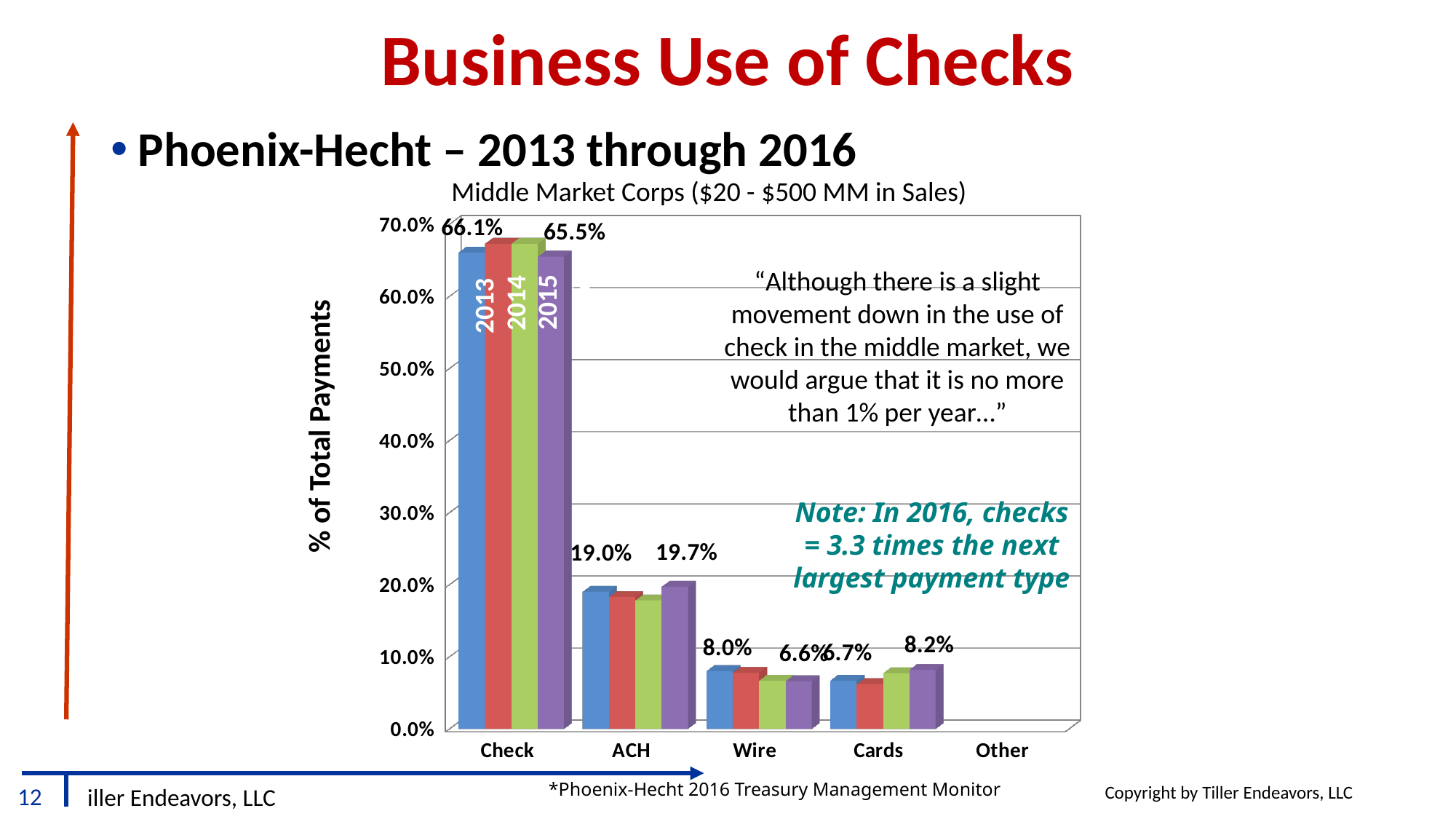
How many payment-type categories are shown on the x axis? 5 What is the difference between the rightmost Cards value (8.2%) and the 2013 Cards value (6.7%)? 1.5 percentage points What is the value of the rightmost (purple) bar for Check? 65.5% What is the value of the rightmost (purple) bar for Cards? 8.2% Which payment type has the highest share of total payments? Check What is the value of the 2013 bar for ACH? 19.0% What is the difference between the 2013 Check value (66.1%) and the rightmost Check value (65.5%)? 0.6 percentage points Which is larger for Wire: the 2013 bar or the rightmost (purple) bar? The 2013 bar Is the value of the 2014 bar for ACH greater or less than 20.0%? less What is the value of the 2013 bar for Wire? 8.0% What is the y-axis title of the chart? % of Total Payments What is the value of the 2013 bar for Check? 66.1%